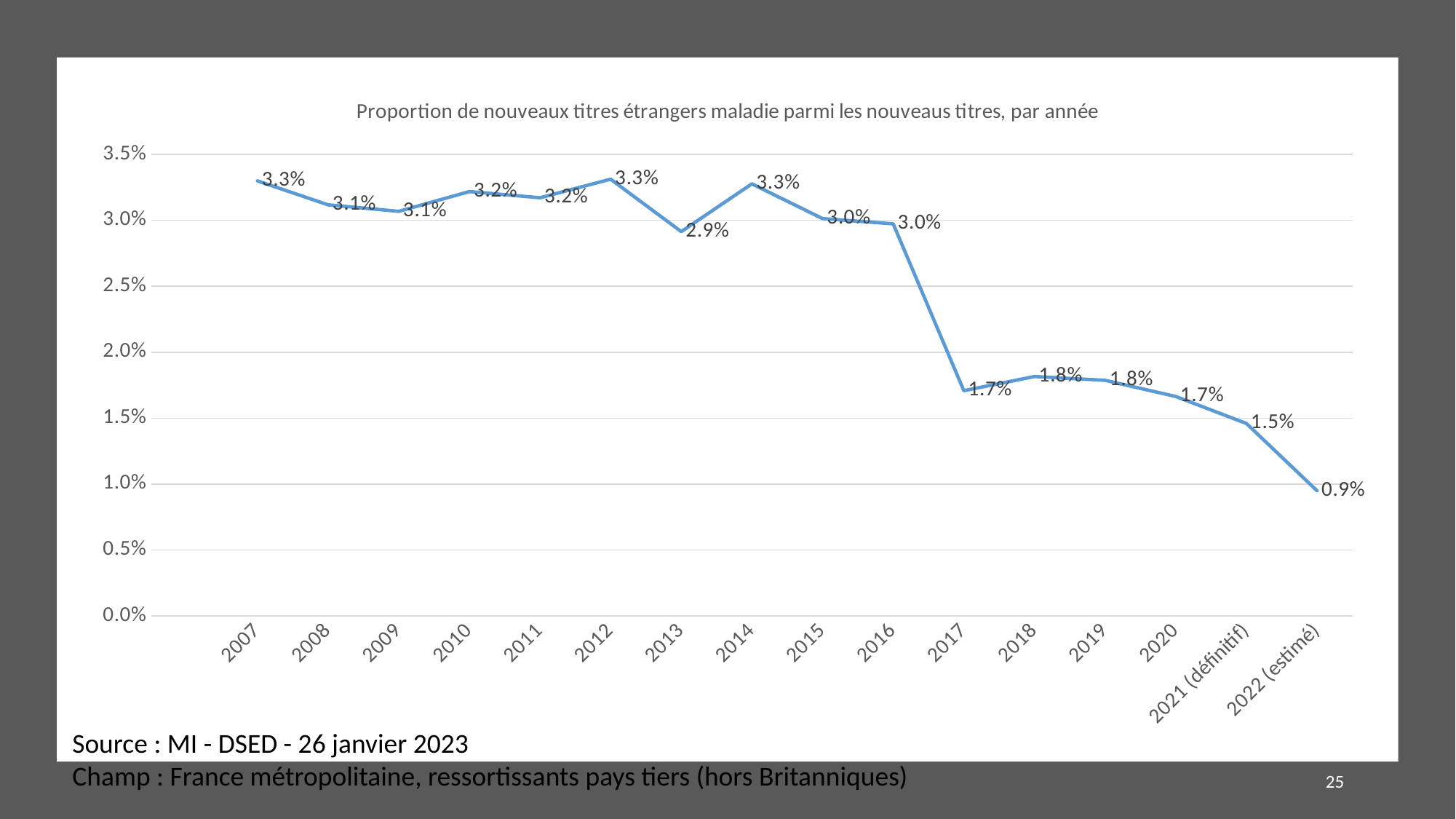
What is the difference between the values for 2016 and 2017? 1.3 percentage points What is the value for 2017? 1.7% How many years are plotted on the x axis? 16 What is the value for 2022 (estimé)? 0.9% Which year has the lowest value? 2022 (estimé) What type of chart is shown on the slide? Line chart What is the difference between the values for 2007 and 2022 (estimé)? 2.4 percentage points Overall, do the values rise or fall from 2007 to 2022? fall What is the value for 2021 (définitif)? 1.5% Is the value for 2018 greater or less than 2.0%? less What is the value for 2013? 2.9% Which is larger, the value for 2014 or the value for 2013? 2014